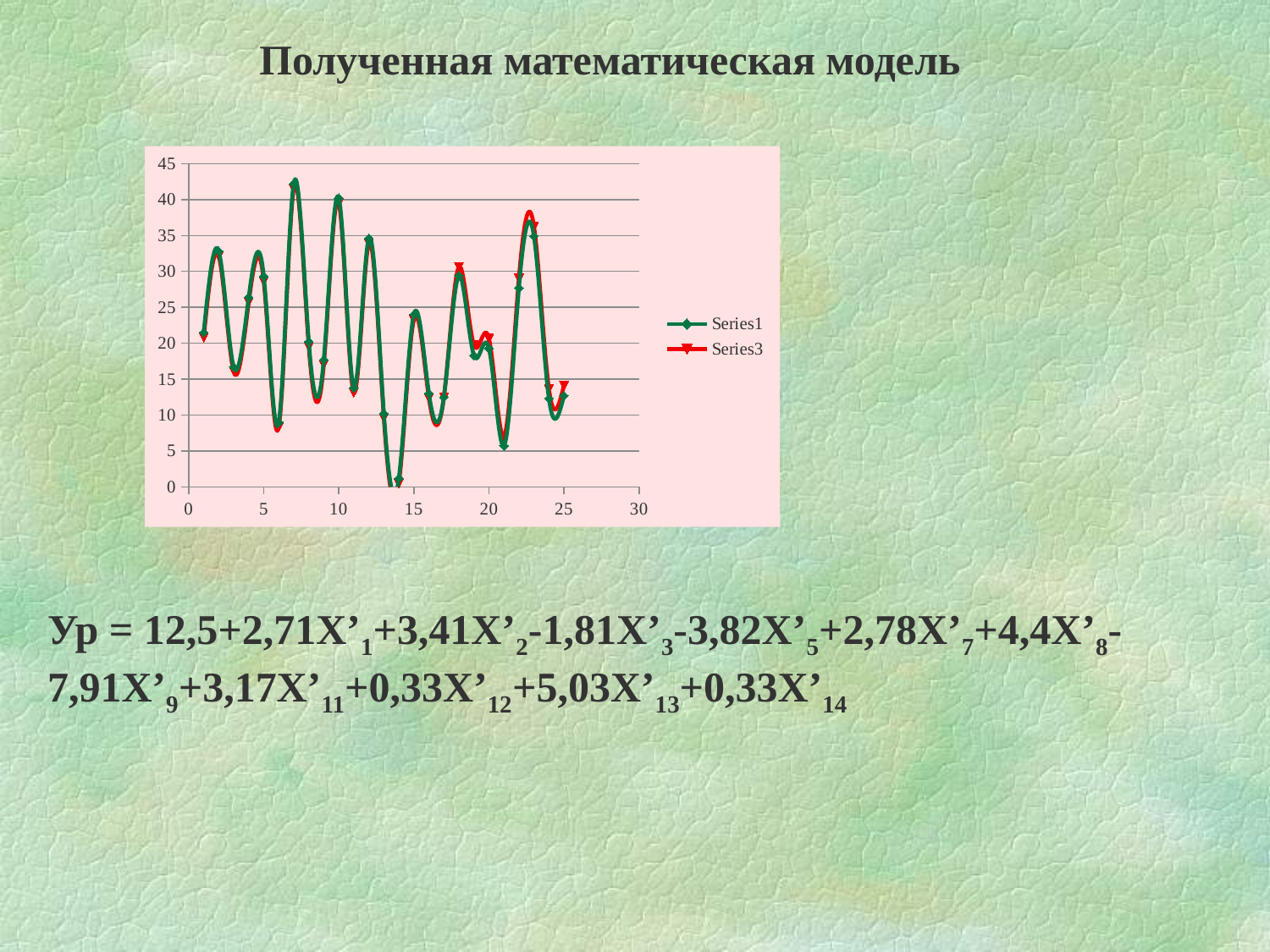
Is the value of Series1 at x = 18 greater or less than 25? greater Is the value of Series1 at x = 14 greater or less than 5? less Is the value of Series1 at x = 12 greater or less than 30? greater What is the highest value shown on the chart's vertical axis? 45 At which x value does Series1 reach its lowest point? 14 What kind of chart is shown on the slide? line chart Which is larger for Series1: the value at x = 7 or the value at x = 14? the value at x = 7 What are the names of the series listed in the chart legend? Series1 and Series3 How many series does the chart legend list? 2